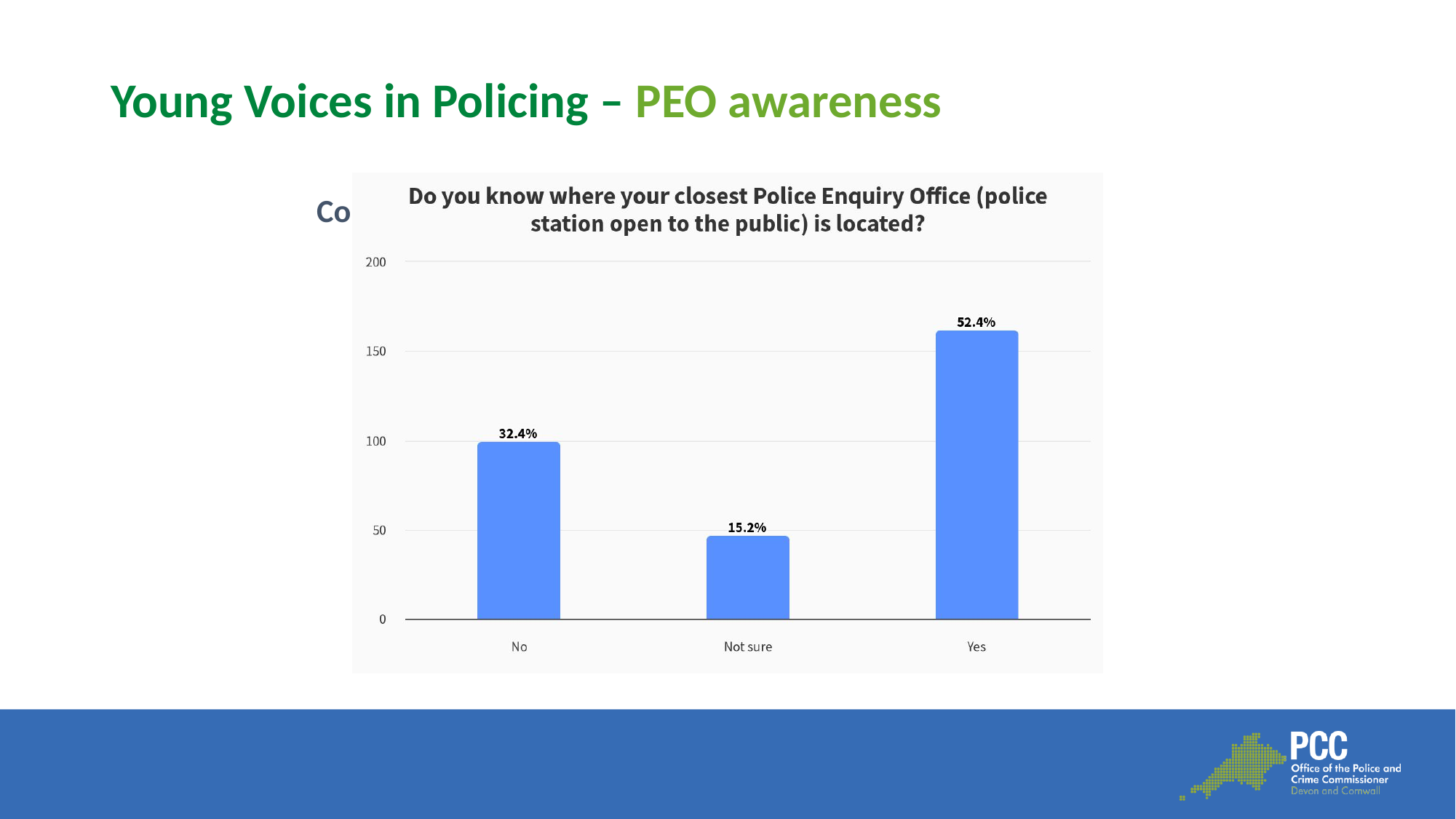
Which response category has the highest value? Yes What percentage label is shown on the 'Yes' bar? 52.4% What percentage label is shown on the 'No' bar? 32.4% How many response categories are shown on the x axis? 3 Which is larger, the value for 'No' or the value for 'Not sure'? No What question is shown as the chart title? Do you know where your closest Police Enquiry Office (police station open to the public) is located? What kind of chart is shown on the slide? Bar chart What is the difference in percentage points between the 'Yes' and 'No' labels? 20.0% Which response category has the lowest value? Not sure What is the difference in percentage points between the 'No' and 'Not sure' labels? 17.2% What percentage label is shown on the 'Not sure' bar? 15.2% Is the count for 'Yes' greater or less than 150 on the y axis? greater